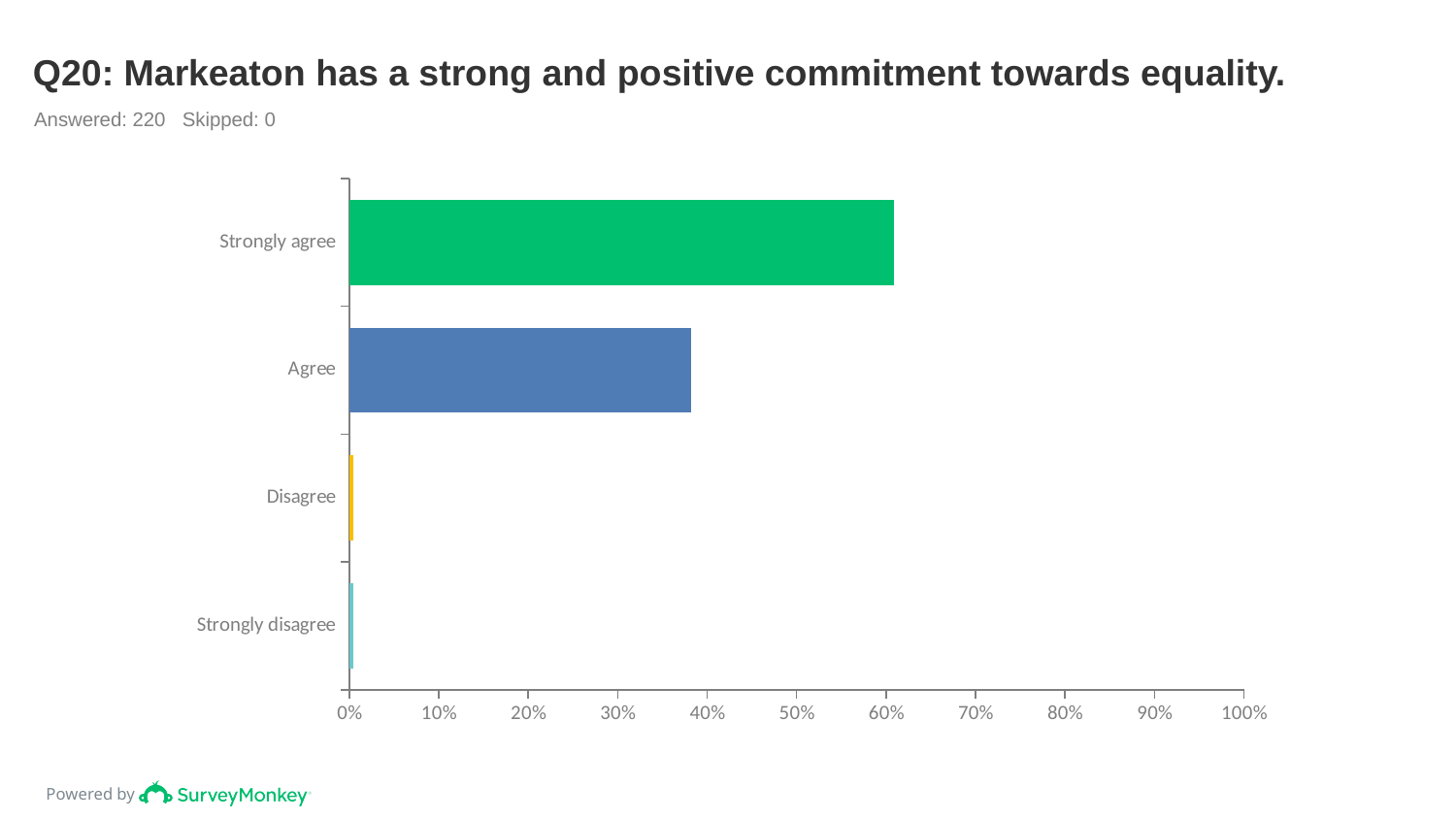
Is the value for Disagree greater or less than 10%? less How many respondents answered this question according to the slide? 220 Is the value for Agree greater or less than 40%? less How many response categories are shown on the chart? 4 Is the value for Strongly agree greater or less than 70%? less What is the title of the chart? Q20: Markeaton has a strong and positive commitment towards equality. What kind of chart is shown on the slide? bar chart Which response category has the highest value? Strongly agree Which is larger, the value for Strongly agree or the value for Agree? Strongly agree Which is larger, the value for Agree or the value for Disagree? Agree